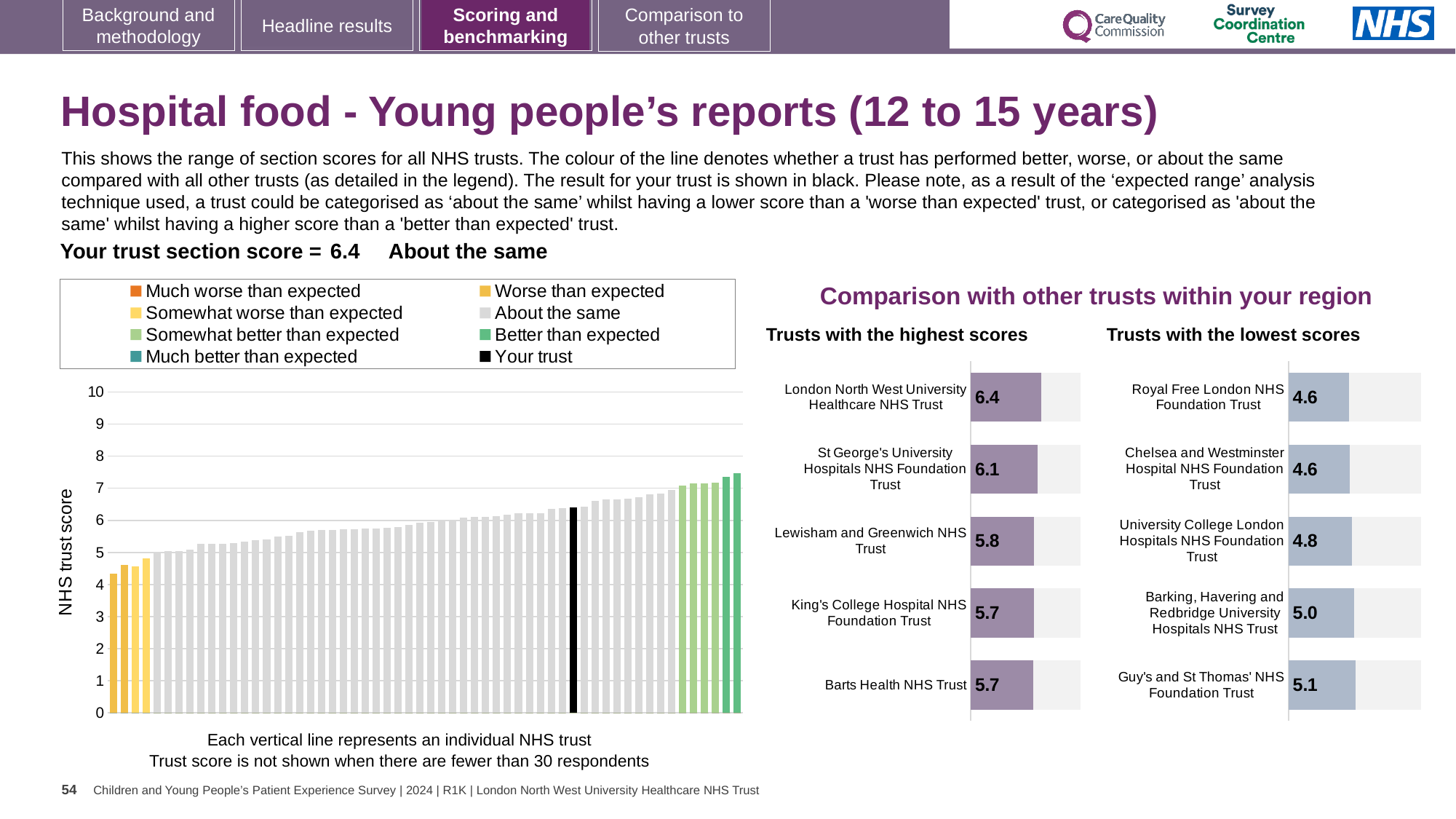
In the 'Trusts with the highest scores' chart, what is the score for London North West University Healthcare NHS Trust? 6.4 What kind of chart is the NHS trust score chart on the left of the slide? Bar chart In the 'Trusts with the lowest scores' chart, which has the larger score: Barking, Havering and Redbridge University Hospitals NHS Trust or Royal Free London NHS Foundation Trust? Barking, Havering and Redbridge University Hospitals NHS Trust In the 'Trusts with the highest scores' chart, what is the score for Lewisham and Greenwich NHS Trust? 5.8 In the 'Trusts with the highest scores' chart, which trust has the highest score? London North West University Healthcare NHS Trust How many trusts are listed in the 'Trusts with the lowest scores' chart? 5 In the NHS trust score chart on the left, do the values rise or fall from left to right? Rise In the 'Trusts with the highest scores' chart, what is the difference between the scores of London North West University Healthcare NHS Trust and St George's University Hospitals NHS Foundation Trust? 0.3 In the 'Trusts with the lowest scores' chart, what is the score for University College London Hospitals NHS Foundation Trust? 4.8 In the 'Trusts with the lowest scores' chart, which trust has the highest score shown? Guy's and St Thomas' NHS Foundation Trust How many entries does the legend of the NHS trust score chart list? 8 In the 'Trusts with the lowest scores' chart, what is the score for Guy's and St Thomas' NHS Foundation Trust? 5.1